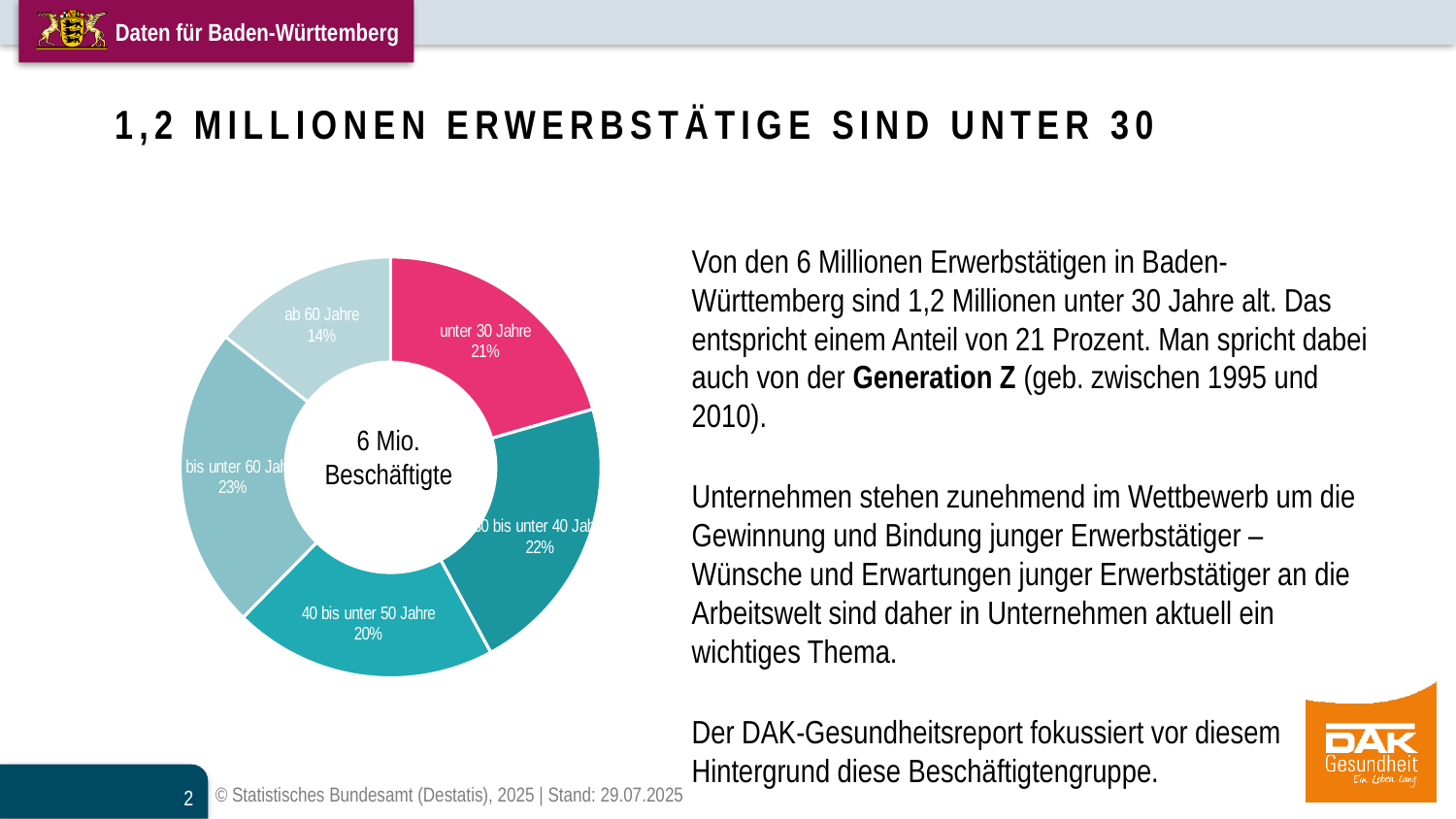
What share of the pie chart is the slice 'ab 60 Jahre'? 14% Which age group has the smallest slice in the pie chart? ab 60 Jahre What share of the pie chart is the slice '30 bis unter 40 Jahre'? 22% What is the difference in percentage points between the 'unter 30 Jahre' slice and the 'ab 60 Jahre' slice? 7 percentage points Which age group has the largest slice in the pie chart? 50 bis unter 60 Jahre What share of the pie chart is the slice '50 bis unter 60 Jahre'? 23% Which slice is larger, 'unter 30 Jahre' or '40 bis unter 50 Jahre'? unter 30 Jahre What share of the pie chart is the slice 'unter 30 Jahre'? 21% What text is shown in the centre of the donut chart? 6 Mio. Beschäftigte What share of the pie chart is the slice '40 bis unter 50 Jahre'? 20% How many slices does the pie chart have? 5 What kind of chart is shown on the slide? pie chart (donut)